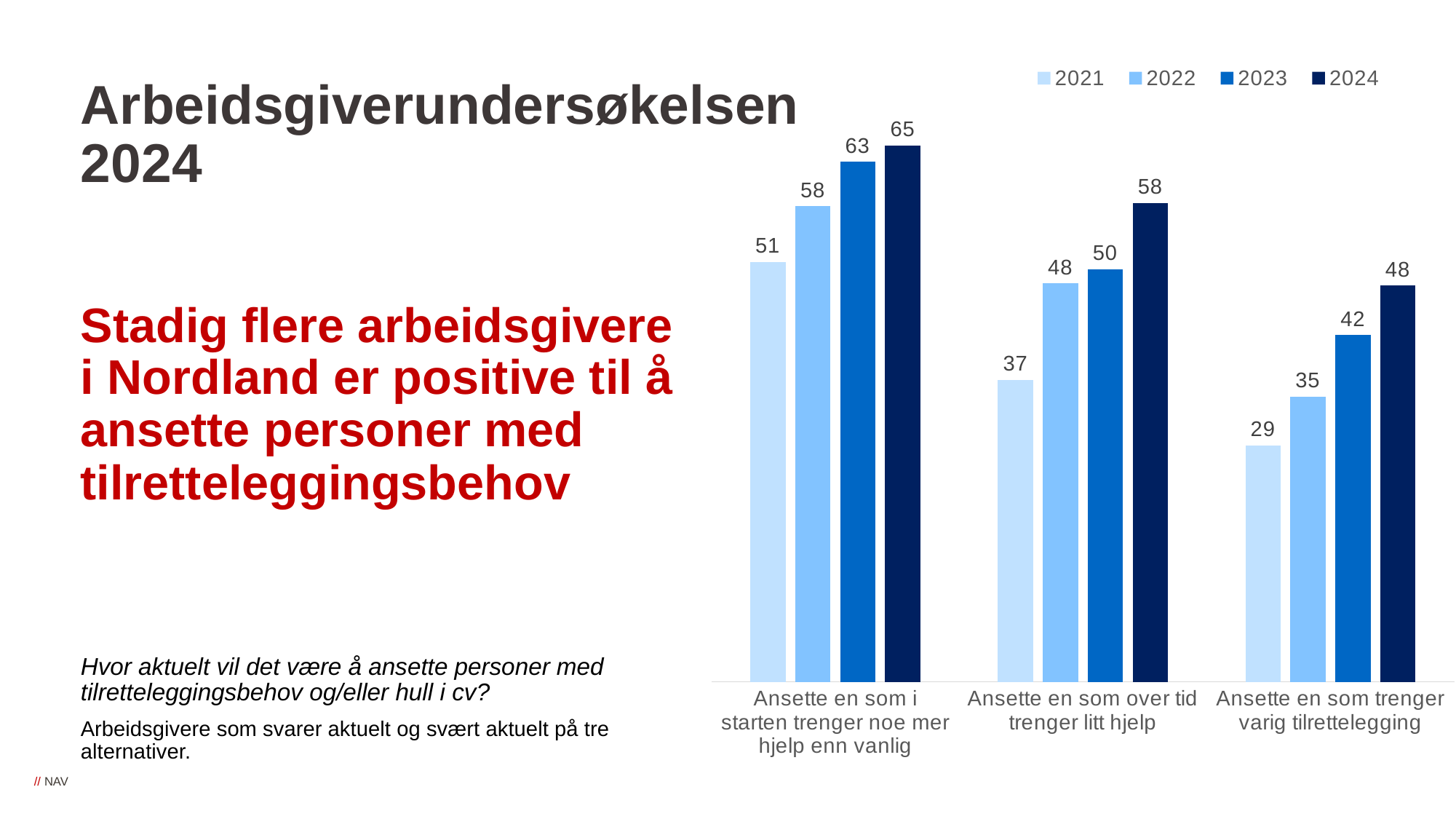
What kind of chart is shown on the slide? Bar chart Within the category "Ansette en som over tid trenger litt hjelp", do the values rise or fall from 2021 to 2024? Rise Which category has the highest value for 2024? Ansette en som i starten trenger noe mer hjelp enn vanlig What is the value for 2024 in the category "Ansette en som i starten trenger noe mer hjelp enn vanlig"? 65 Which category has the lowest value for 2021? Ansette en som trenger varig tilrettelegging What is the difference between the 2023 and 2022 values for "Ansette en som i starten trenger noe mer hjelp enn vanlig"? 5 Which is larger: the 2023 value for "Ansette en som over tid trenger litt hjelp" or the 2023 value for "Ansette en som trenger varig tilrettelegging"? Ansette en som over tid trenger litt hjelp What is the value for 2022 in the category "Ansette en som over tid trenger litt hjelp"? 48 What is the difference between the 2024 and 2021 values for "Ansette en som trenger varig tilrettelegging"? 19 How many series does the legend list? 4 How many categories are shown on the x axis? 3 What is the value for 2021 in the category "Ansette en som trenger varig tilrettelegging"? 29